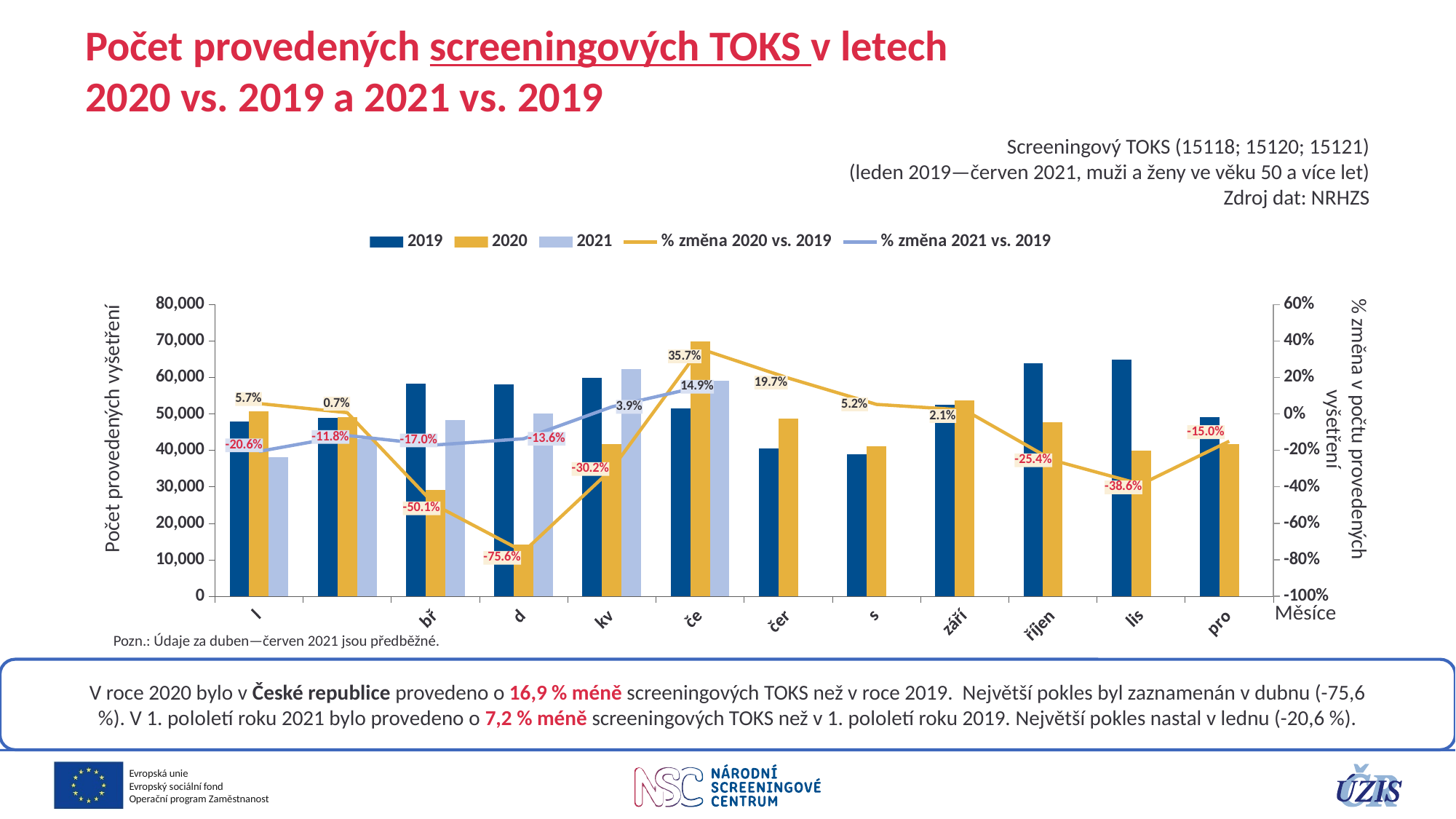
What is the % změna 2020 vs. 2019 value for the month d? -75.6% In which month is the % změna 2020 vs. 2019 line lowest? d What is the % změna 2021 vs. 2019 value for the month če? 14.9% For the month l, which bar is taller: 2019 or 2021? 2019 Is the 2019 bar for the month lis greater or less than 60,000? greater What is the % změna 2020 vs. 2019 value for the month lis? -38.6% How many series does the chart legend list? 5 What is the % změna 2021 vs. 2019 value for the month l? -20.6% What is the difference between the % změna 2020 vs. 2019 values for če and čer? 16.0 percentage points What kind of chart is shown on the slide? Bar chart combined with line series In which month is the % změna 2020 vs. 2019 line highest? če Is the 2020 bar for the month d greater or less than 20,000? less